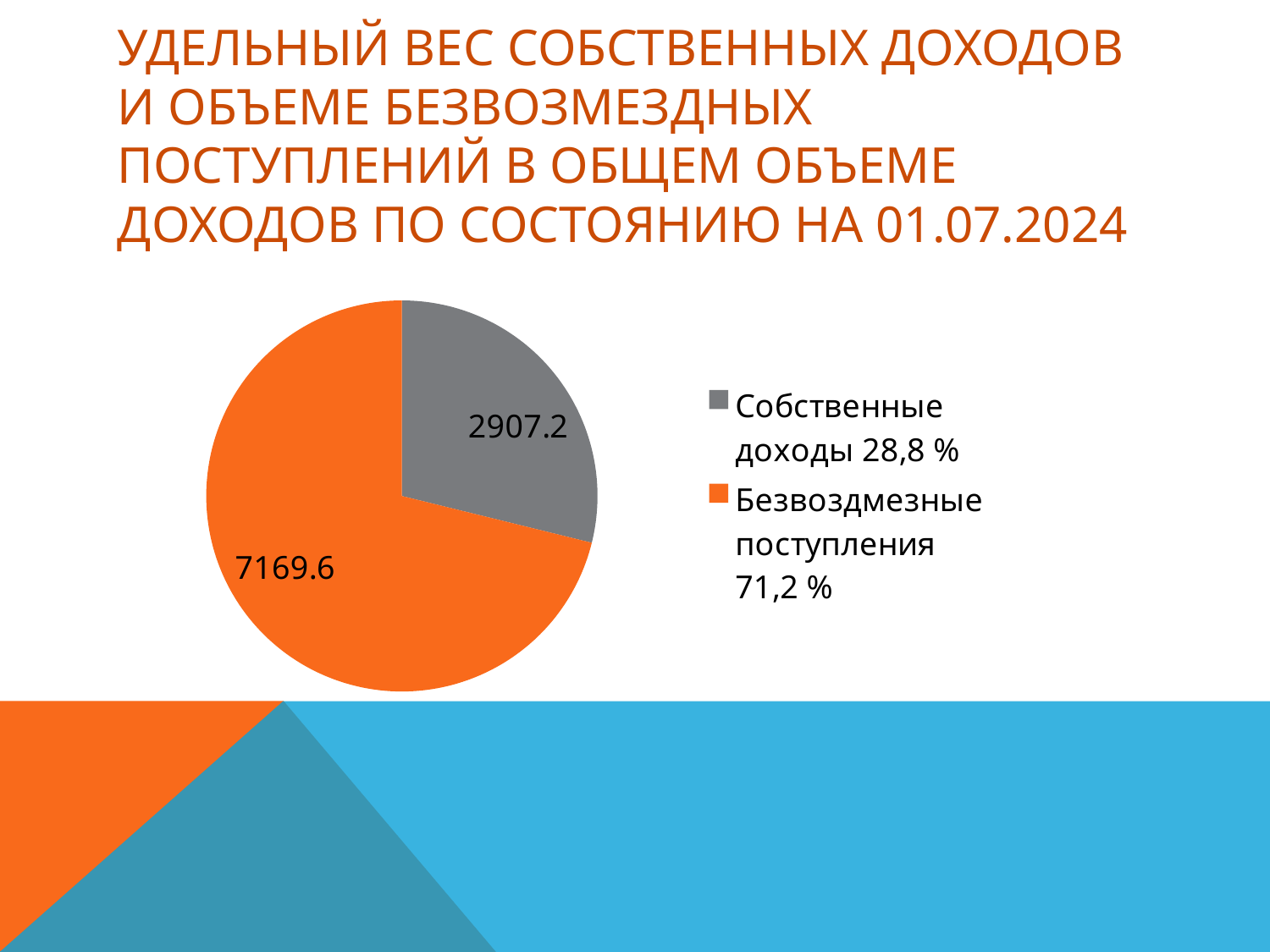
How many entries does the legend list? 2 What share of the pie does "Собственные доходы" represent, according to the legend? 28,8 % What type of chart is shown on the slide? pie chart Which slice of the pie chart is the smallest? Собственные доходы 28,8 % What share of the pie does "Безвоздмезные поступления" represent, according to the legend? 71,2 % What is the difference between the values 7169.6 and 2907.2 shown on the pie chart? 4262.4 Which slice of the pie chart is the largest? Безвоздмезные поступления 71,2 % What colour is the slice for "Собственные доходы"? gray What is the value of the slice labelled "Собственные доходы 28,8 %"? 2907.2 Which is larger: the value for "Собственные доходы" or the value for "Безвоздмезные поступления"? Безвоздмезные поступления How many slices does the pie chart have? 2 What is the value of the slice labelled "Безвоздмезные поступления 71,2 %"? 7169.6